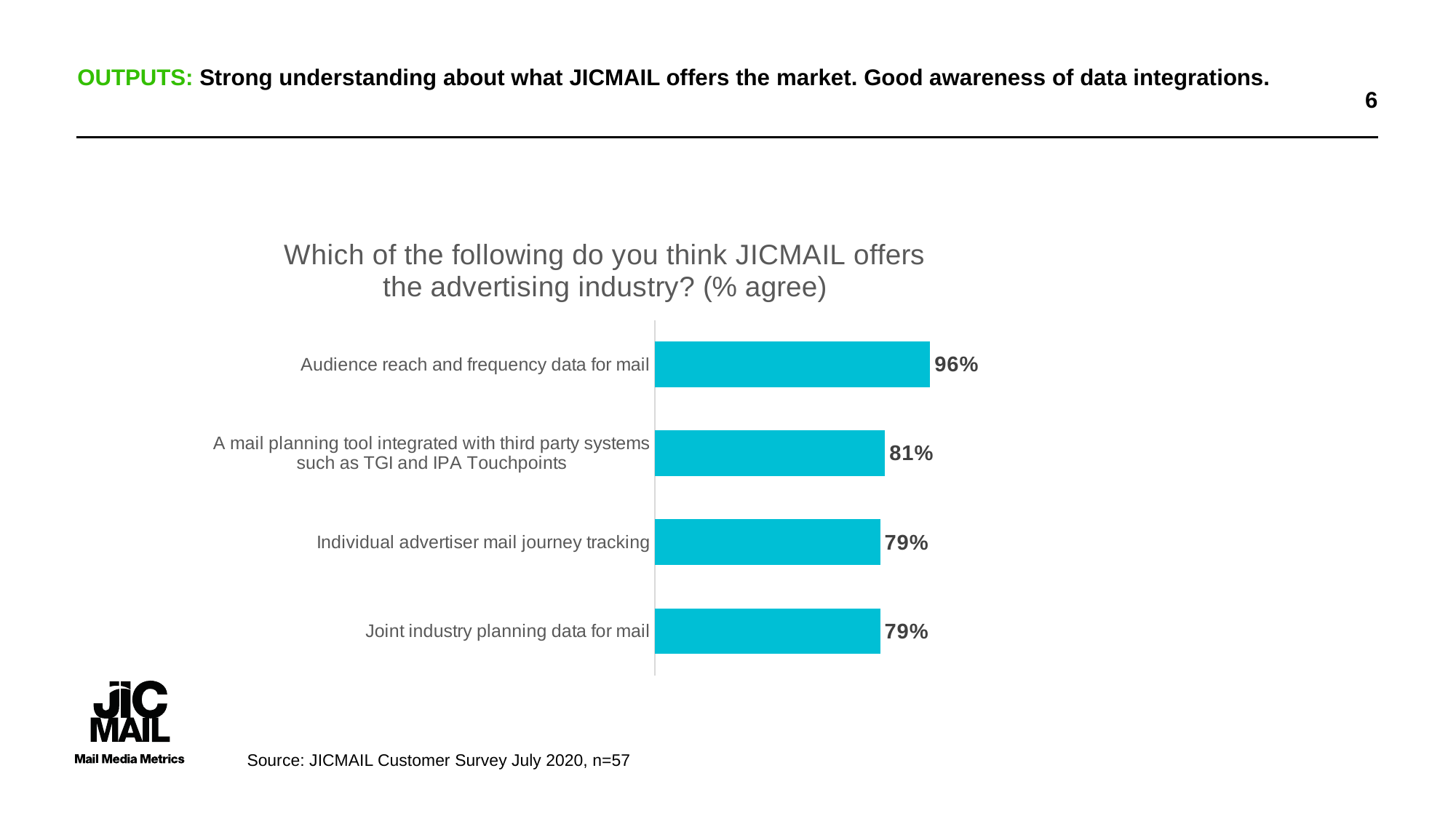
What percentage agree that JICMAIL offers individual advertiser mail journey tracking? 79% What is the sample size (n) given in the source note below the chart? n=57 What is the difference in percentage points between 'Audience reach and frequency data for mail' and 'A mail planning tool integrated with third party systems such as TGI and IPA Touchpoints'? 15 percentage points What percentage agree that JICMAIL offers joint industry planning data for mail? 79% What percentage agree that JICMAIL offers audience reach and frequency data for mail? 96% Which category has the highest percentage of agreement? Audience reach and frequency data for mail How many categories are shown in the chart? 4 What kind of chart is shown on the slide? Bar chart What is the title of the chart? Which of the following do you think JICMAIL offers the advertising industry? (% agree) What percentage agree that JICMAIL offers a mail planning tool integrated with third party systems such as TGI and IPA Touchpoints? 81% Which has a higher percentage of agreement: 'A mail planning tool integrated with third party systems such as TGI and IPA Touchpoints' or 'Individual advertiser mail journey tracking'? A mail planning tool integrated with third party systems such as TGI and IPA Touchpoints What is the difference in percentage points between 'Audience reach and frequency data for mail' and 'Joint industry planning data for mail'? 17 percentage points